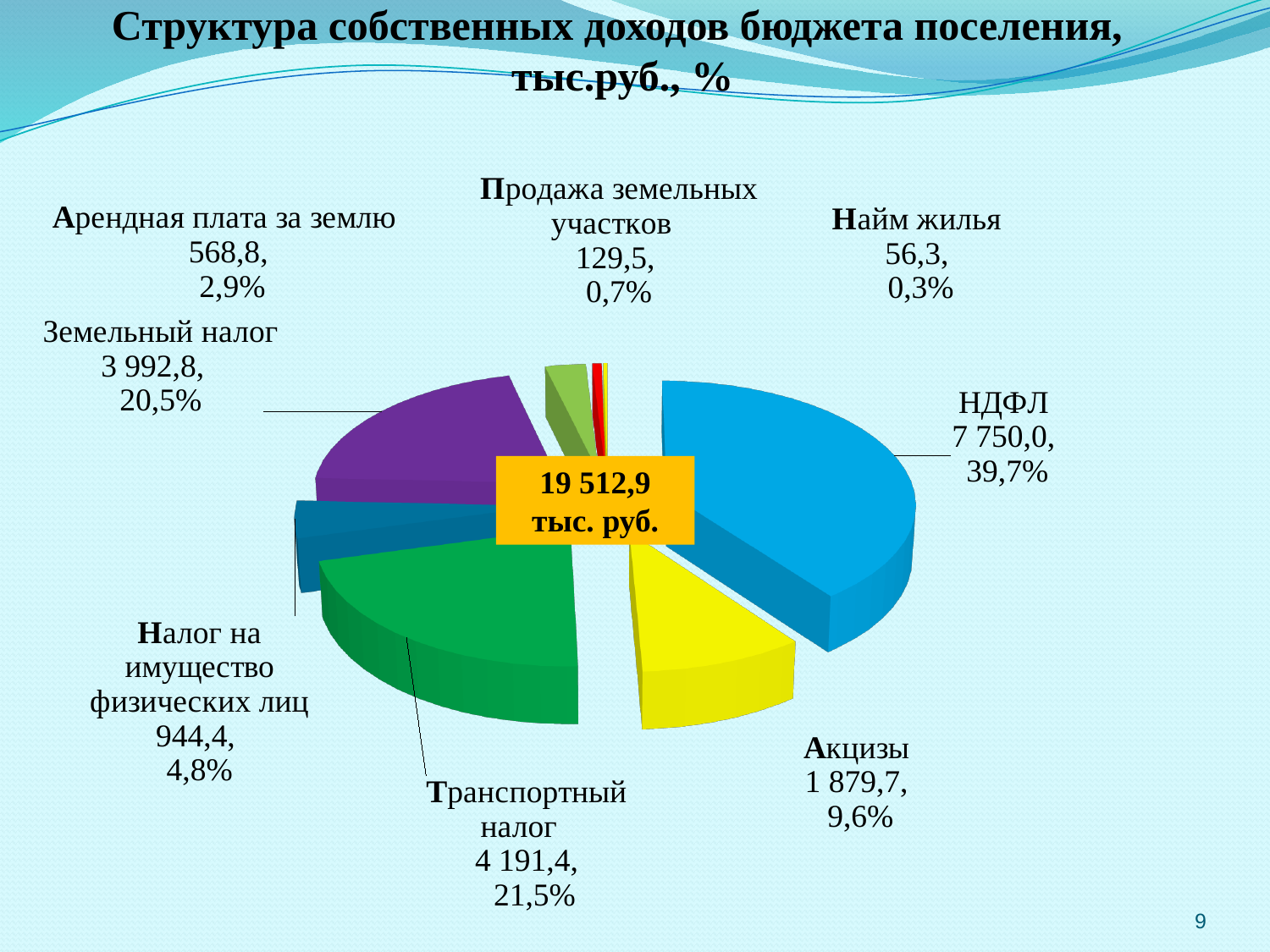
Which category has the largest share of the pie? НДФЛ What kind of chart is shown on the slide? pie chart Which is larger, Земельный налог or Налог на имущество физических лиц? Земельный налог What is the value for Арендная плата за землю in тыс. руб.? 568,8 What total amount is shown in the centre of the pie chart? 19 512,9 тыс. руб. Which category has the smallest share of the pie? Найм жилья What share of the pie does Земельный налог have? 20,5% What is the value for Акцизы in тыс. руб.? 1 879,7 What share of the pie does Транспортный налог have? 21,5% How many categories (slices) does the pie chart show? 8 What is the value for НДФЛ in тыс. руб.? 7 750,0 What is the difference in percentage points between the shares of НДФЛ and Транспортный налог? 18,2